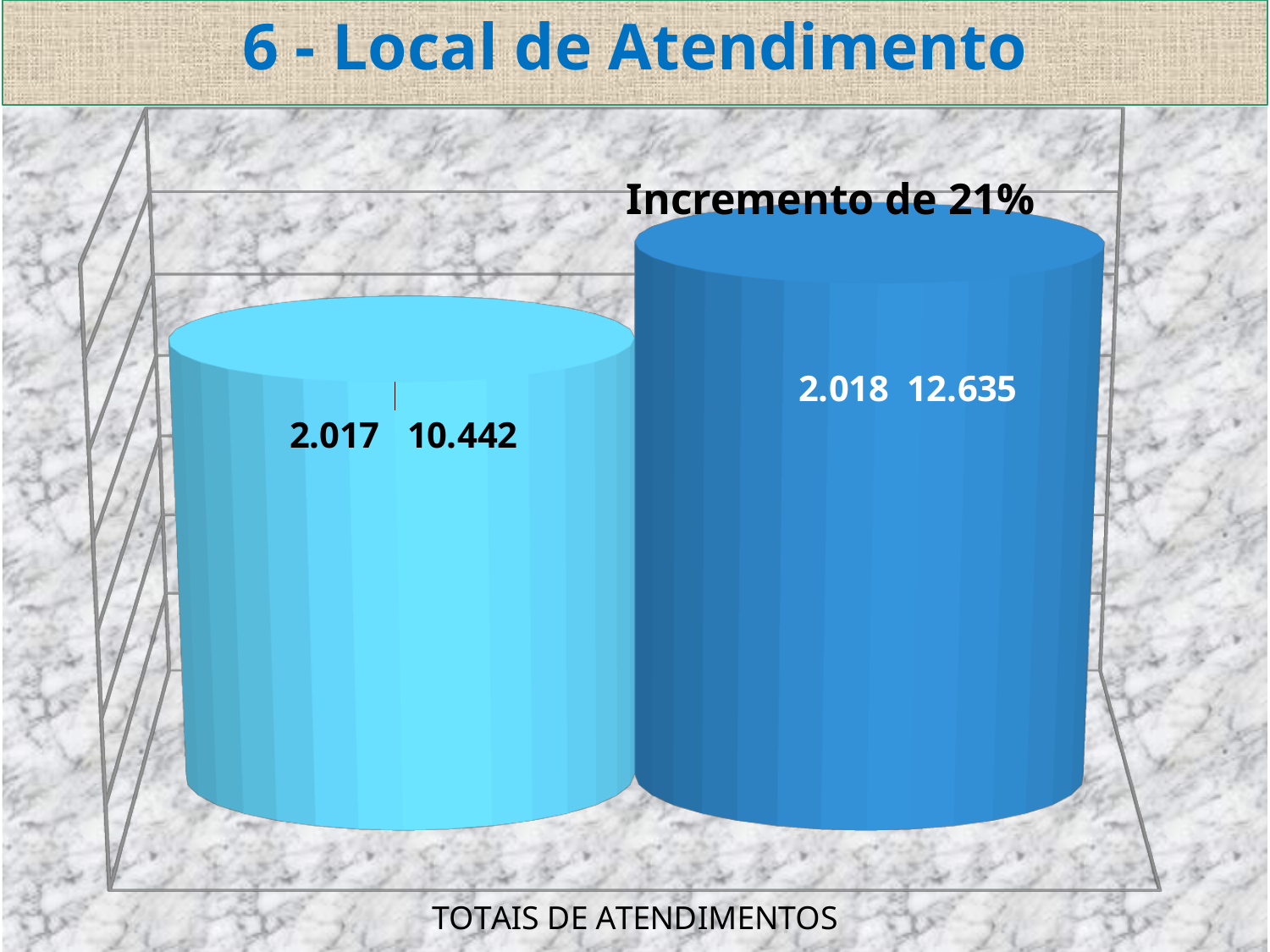
Do the values rise or fall from 2.017 to 2.018? rise Which year has the lower total of atendimentos? 2.017 How many bars are plotted in the chart? 2 What label appears below the chart? TOTAIS DE ATENDIMENTOS Is the value for 2.018 larger or smaller than the value for 2.017? larger What kind of chart is shown on the slide? bar chart What is the difference between the values for 2.018 and 2.017? 2.193 What percentage increase is annotated on the chart? 21% Which year has the higher total of atendimentos? 2.018 What is the value shown for 2.018? 12.635 What is the value shown for 2.017? 10.442